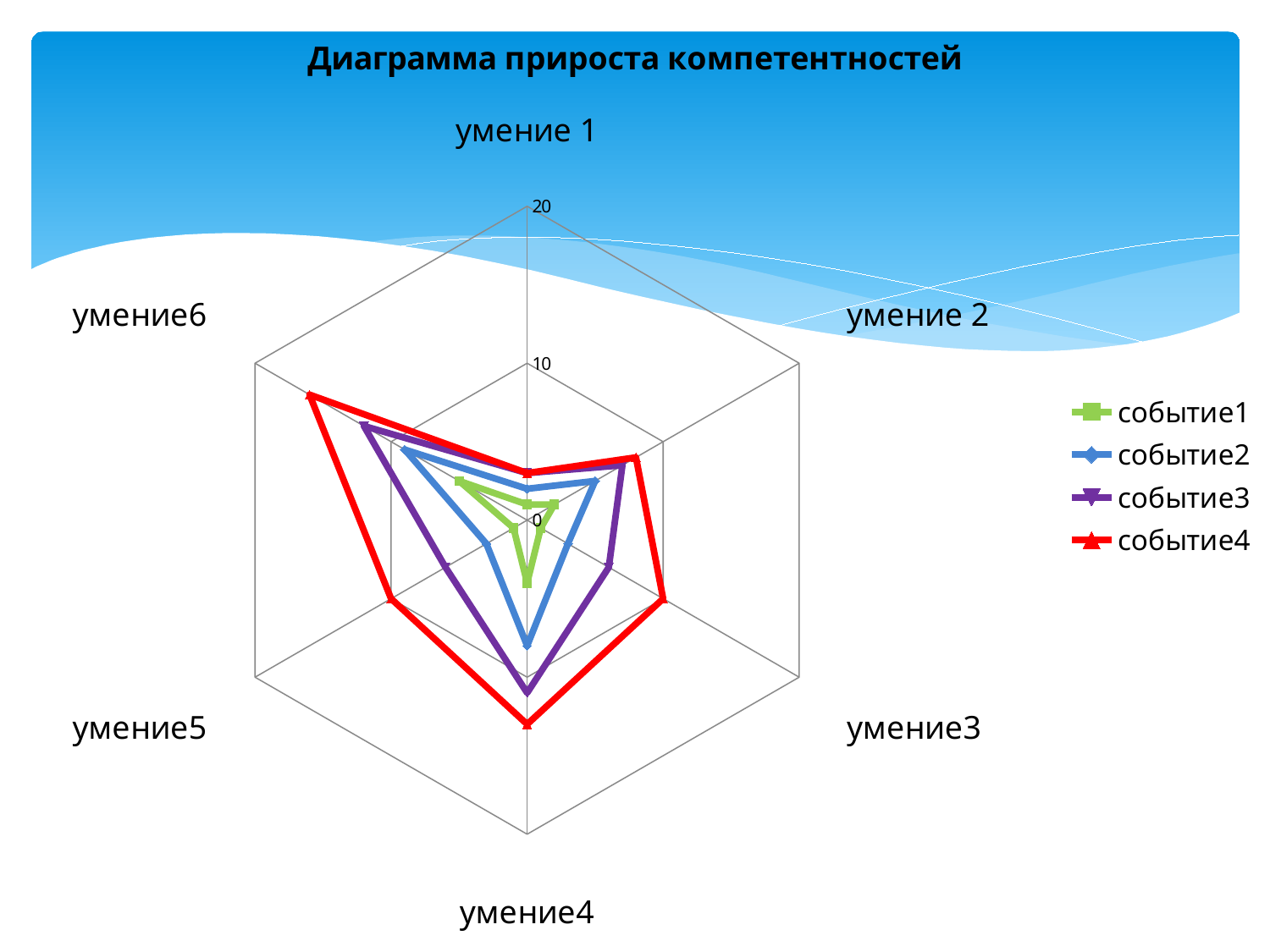
Which colour represents the series событие4? Red Is the value of событие4 for умение4 greater or less than 10? greater For умение4, which is larger: the value of событие4 or the value of событие1? событие4 Is the value of событие1 for умение4 greater or less than 10? less What is the title of the chart? Диаграмма прироста компетентностей Is the value of событие4 for умение6 greater or less than 10? greater For the series событие4, which category has the highest value? умение6 What kind of chart is shown on the slide? Radar chart How many series does the legend list? 4 How many categories (умения) are plotted on the radar chart? 6